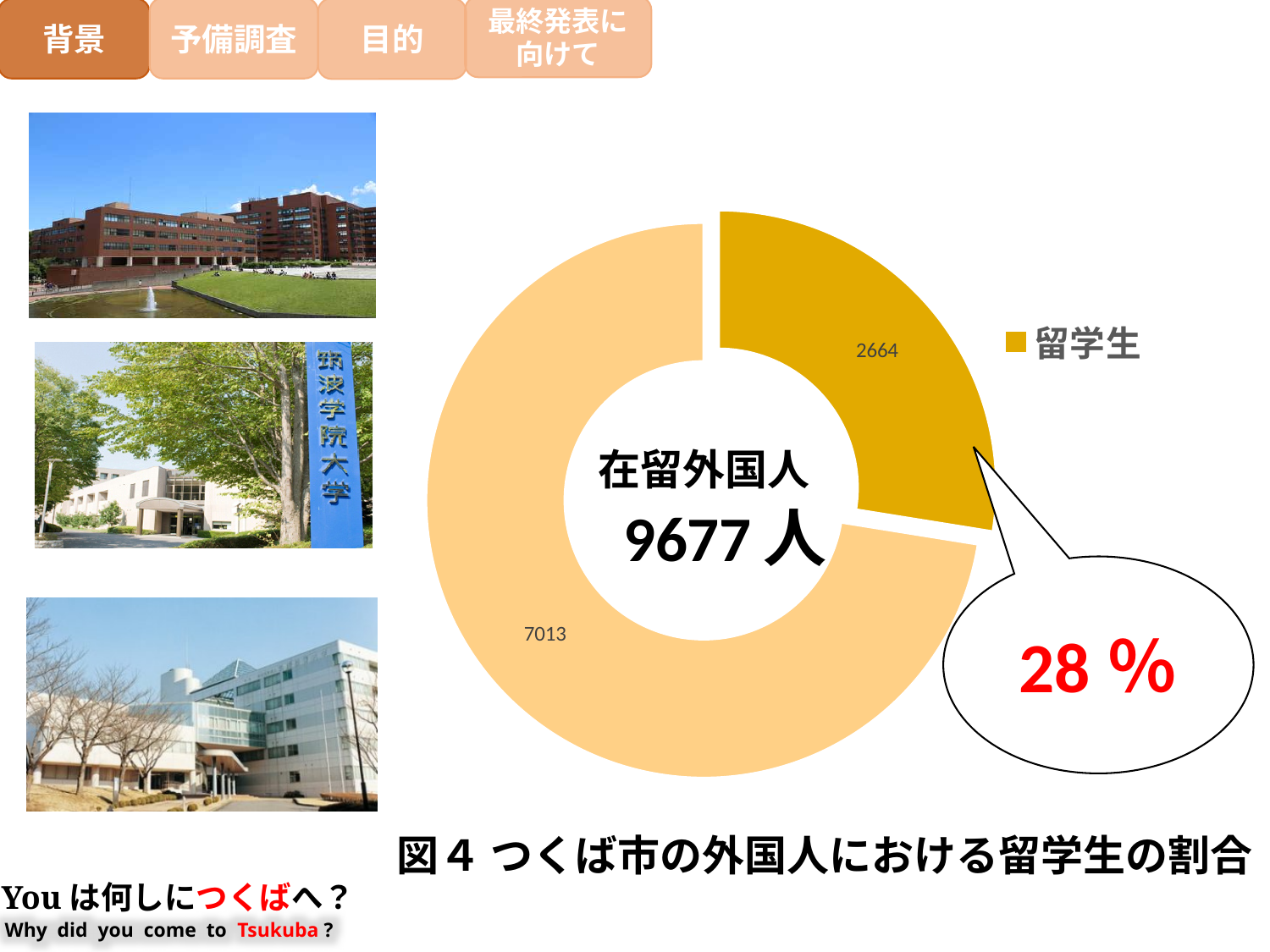
How many slices does the donut chart have? 2 How many entries does the chart legend list? 1 What value is shown for the 留学生 slice of the donut chart? 2664 What label appears in the chart legend? 留学生 What kind of chart is shown on the slide? Donut (pie) chart Is the value of the 留学生 slice greater or less than 3000? less What value is shown on the larger, light-orange slice of the donut chart? 7013 According to the callout, what percentage share does the 留学生 slice represent? 28 % Which slice of the donut chart is larger, the one labelled 2664 or the one labelled 7013? 7013 What is the difference between the two slice values, 7013 and 2664? 4349 What total number of 在留外国人 is printed in the centre of the donut chart? 9677 人 What is the caption (figure title) given below the chart? 図４ つくば市の外国人における留学生の割合